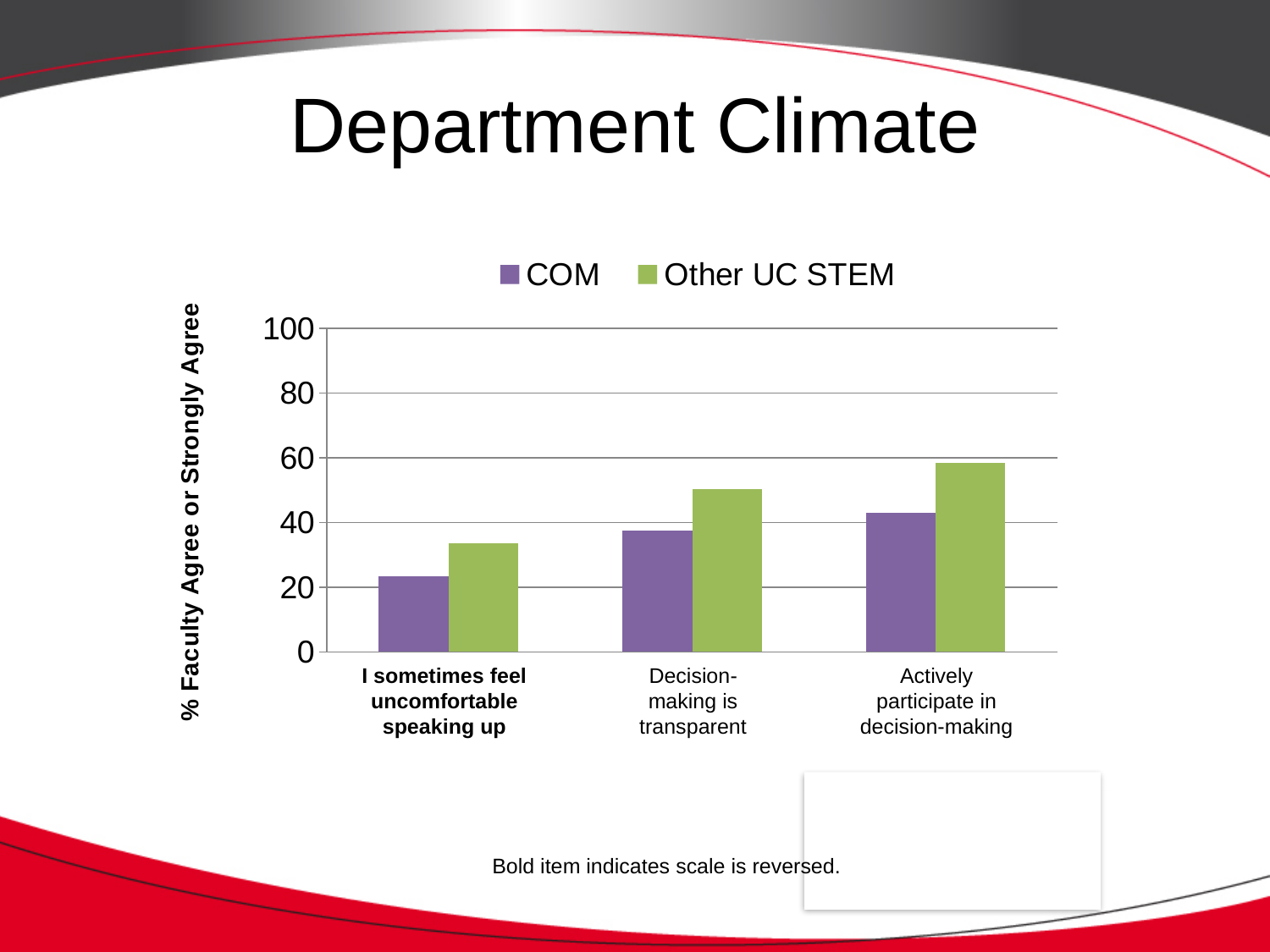
For "Actively participate in decision-making", which series has the larger value, COM or Other UC STEM? Other UC STEM Which category has the lowest COM value? I sometimes feel uncomfortable speaking up Do the COM values rise or fall moving from left to right across the categories? rise What is the label on the vertical axis? % Faculty Agree or Strongly Agree For "Decision-making is transparent", which series has the larger value, COM or Other UC STEM? Other UC STEM How many series does the legend list? 2 Is the Other UC STEM value for "Actively participate in decision-making" greater or less than 40? greater What kind of chart is shown on the slide? bar chart Is the Other UC STEM value for "Decision-making is transparent" greater or less than 60? less Is the COM value for "I sometimes feel uncomfortable speaking up" greater or less than 40? less Which category has the highest Other UC STEM value? Actively participate in decision-making How many categories are shown on the x axis? 3